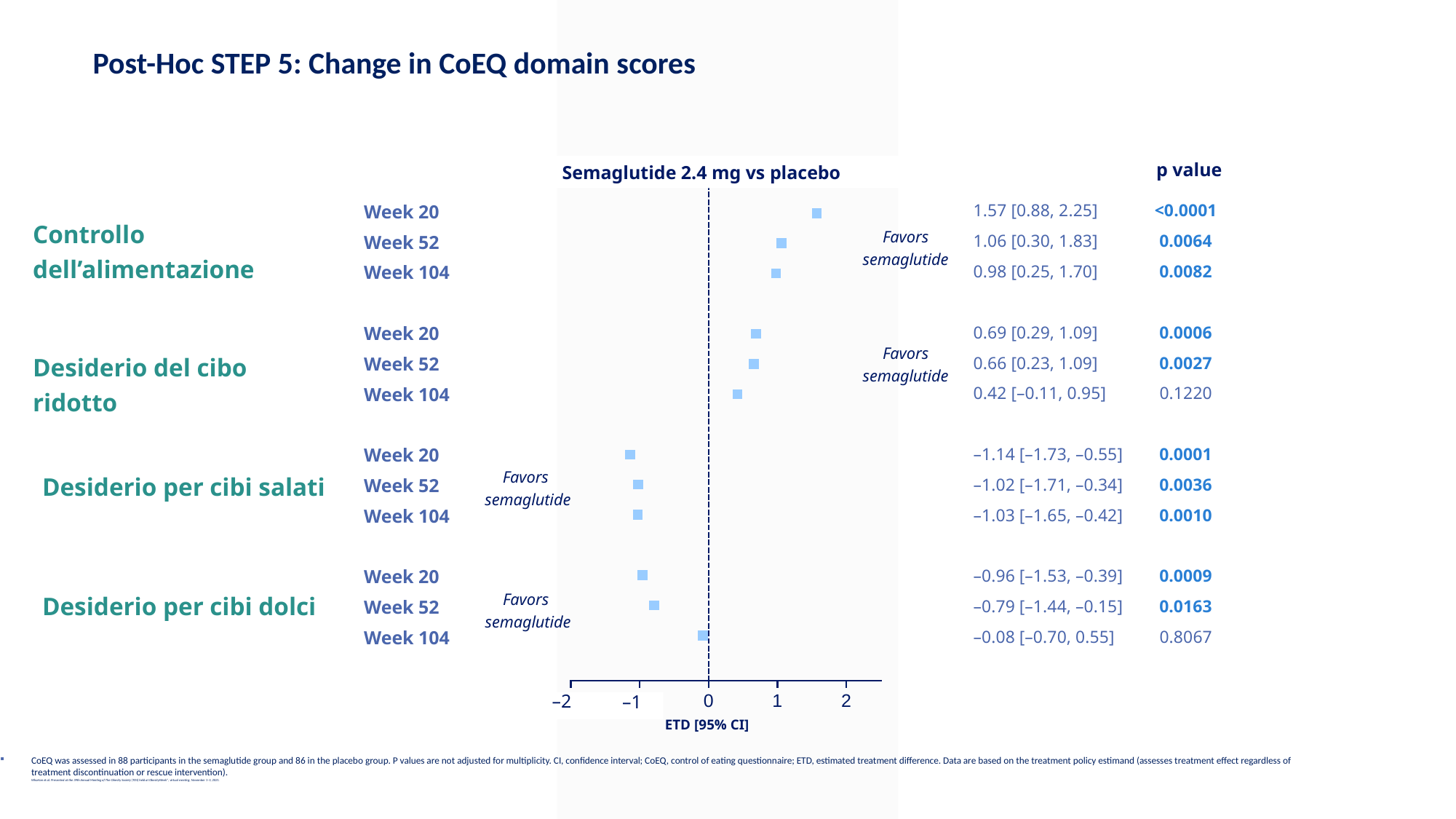
What is the p value for Desiderio del cibo ridotto at Week 104? 0.1220 What is the ETD for Controllo dell'alimentazione at Week 20? 1.57 Which domain and week has the lowest ETD? Desiderio per cibi salati, Week 20 What is the difference between the ETD for Controllo dell'alimentazione at Week 20 and at Week 104? 0.59 What kind of chart is shown on the slide? Forest plot (dot plot with confidence intervals) Is the ETD for Controllo dell'alimentazione at Week 20 greater or less than 1? greater How many data points are plotted in the chart? 12 For Desiderio per cibi dolci, which has the larger ETD: Week 20 or Week 104? Week 104 Which domain and week has the highest ETD? Controllo dell'alimentazione, Week 20 What is the label of the x axis? ETD [95% CI] What is the p value for Controllo dell'alimentazione at Week 20? <0.0001 What is the 95% CI for Desiderio per cibi dolci at Week 52? [–1.44, –0.15]